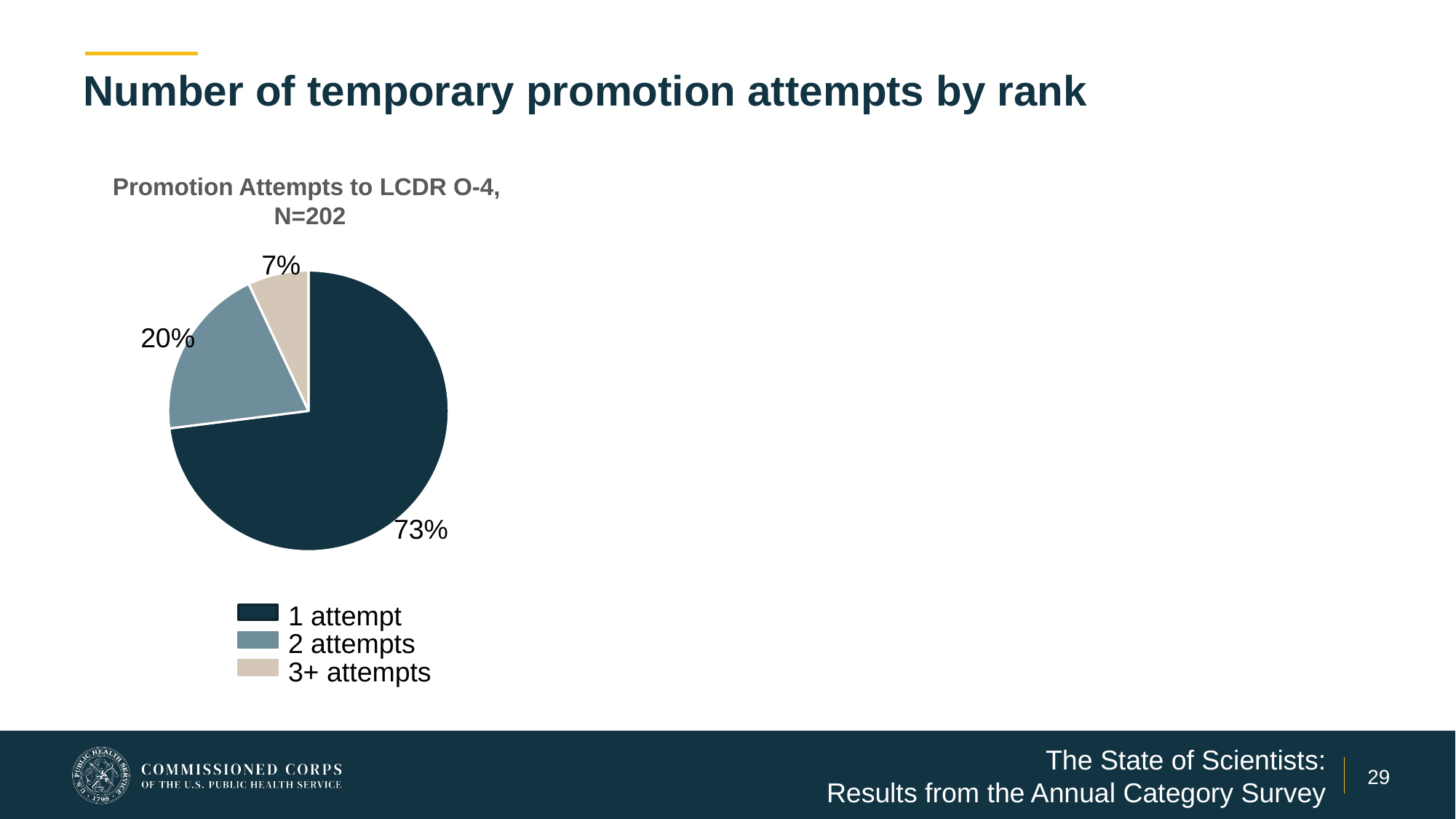
Which category has the smallest slice of the pie? 3+ attempts What kind of chart is shown on the slide? Pie chart What share of the pie is for 3+ attempts? 7% What is the sample size (N) stated in the chart title? 202 What share of the pie is for 2 attempts? 20% How many slices does the pie chart have? 3 What share of the pie is for 1 attempt? 73% Which category has the largest slice of the pie? 1 attempt Which is larger, the slice for 2 attempts or the slice for 3+ attempts? 2 attempts What is the title of the chart? Promotion Attempts to LCDR O-4, N=202 What is the difference in percentage points between the 1 attempt slice and the 2 attempts slice? 53 What is the difference in percentage points between the 2 attempts slice and the 3+ attempts slice? 13